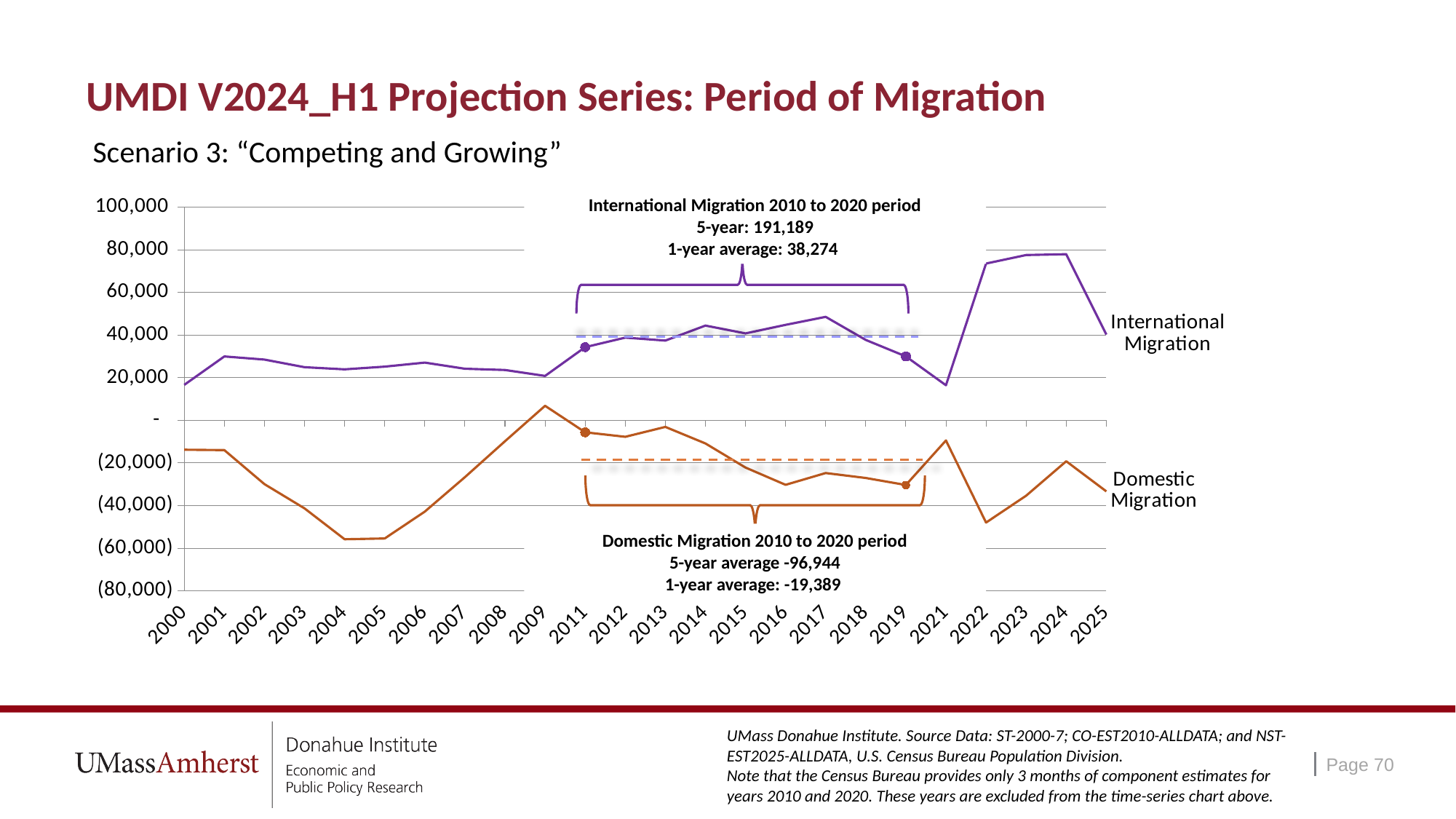
Is the International Migration value for 2022 greater or less than 60,000? greater Is the Domestic Migration value for 2004 greater or less than (40,000)? less According to the annotation, what is the 5-year figure for International Migration in the 2010 to 2020 period? 191,189 In 2024, which series has the higher value, International Migration or Domestic Migration? International Migration Which scenario is named in the subtitle of the slide? Scenario 3: "Competing and Growing" How many data series are plotted on the chart? 2 According to the annotation, what is the 1-year average for International Migration in the 2010 to 2020 period? 38,274 How many years are shown on the x axis of the chart? 24 According to the annotation, what is the 5-year average for Domestic Migration in the 2010 to 2020 period? -96,944 Does the Domestic Migration line rise or fall from 2001 to 2004? fall According to the annotation, what is the 1-year average for Domestic Migration in the 2010 to 2020 period? -19,389 What kind of chart is shown on the slide? line chart